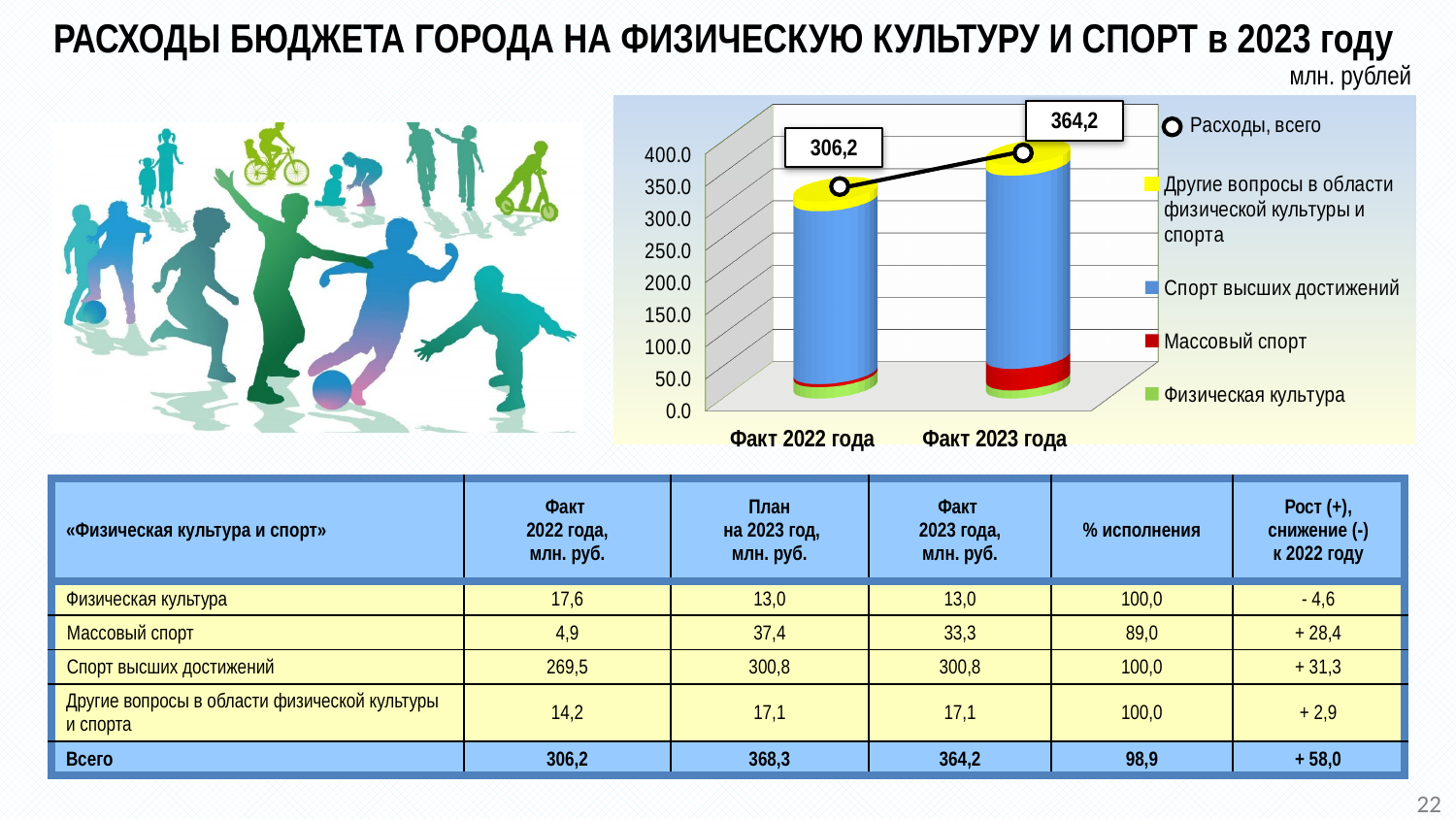
What is the value of «Расходы, всего» for «Факт 2023 года»? 364,2 By how much does the total for «Факт 2023 года» exceed the total for «Факт 2022 года»? 58,0 Is the total value for «Факт 2022 года» greater or less than 250.0? greater How many categories are shown on the x axis of the chart? 2 Which category has the higher total expenditure, «Факт 2022 года» or «Факт 2023 года»? Факт 2023 года Which legend entry is shown in blue? Спорт высших достижений What kind of chart is shown on the slide? Stacked bar chart with a line Is the total value for «Факт 2023 года» greater or less than 350.0? greater Do the total expenditures rise or fall from «Факт 2022 года» to «Факт 2023 года»? rise What is the value of «Расходы, всего» for «Факт 2022 года»? 306,2 How many entries does the chart legend list? 5 What unit is indicated for the chart values? млн. рублей